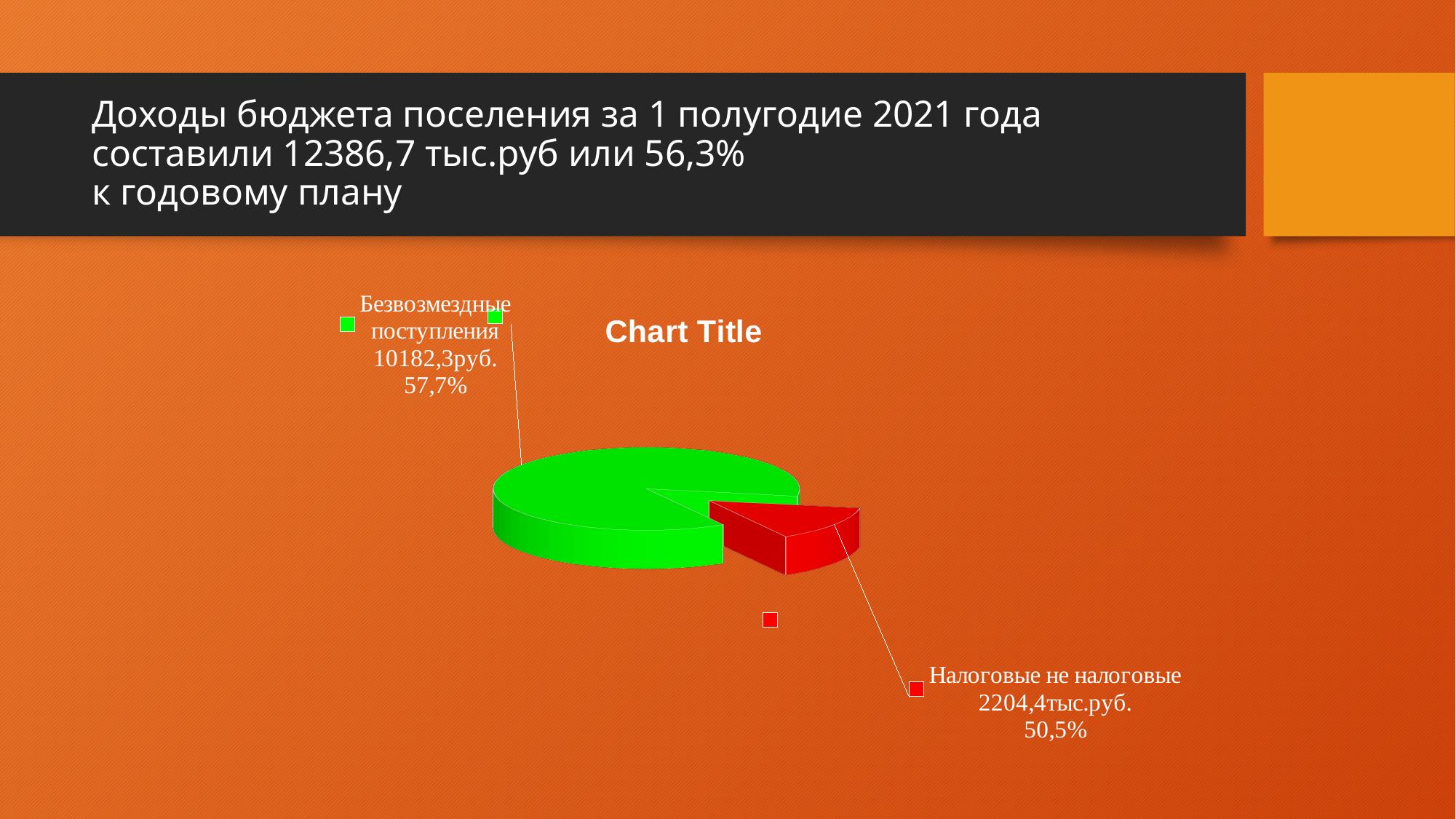
What value is printed for Безвозмездные поступления? 10182,3руб. Which slice of the pie chart is the smallest? Налоговые не налоговые What percentage is printed in the label for Налоговые не налоговые? 50,5% What colour is the Безвозмездные поступления slice? green What value is printed for Налоговые не налоговые? 2204,4тыс.руб. Which is larger: Безвозмездные поступления or Налоговые не налоговые? Безвозмездные поступления Which slice of the pie chart is the largest? Безвозмездные поступления What kind of chart is shown on the slide? pie chart What is the title shown on the chart? Chart Title How many slices does the pie chart have? 2 What percentage is printed in the label for Безвозмездные поступления? 57,7%